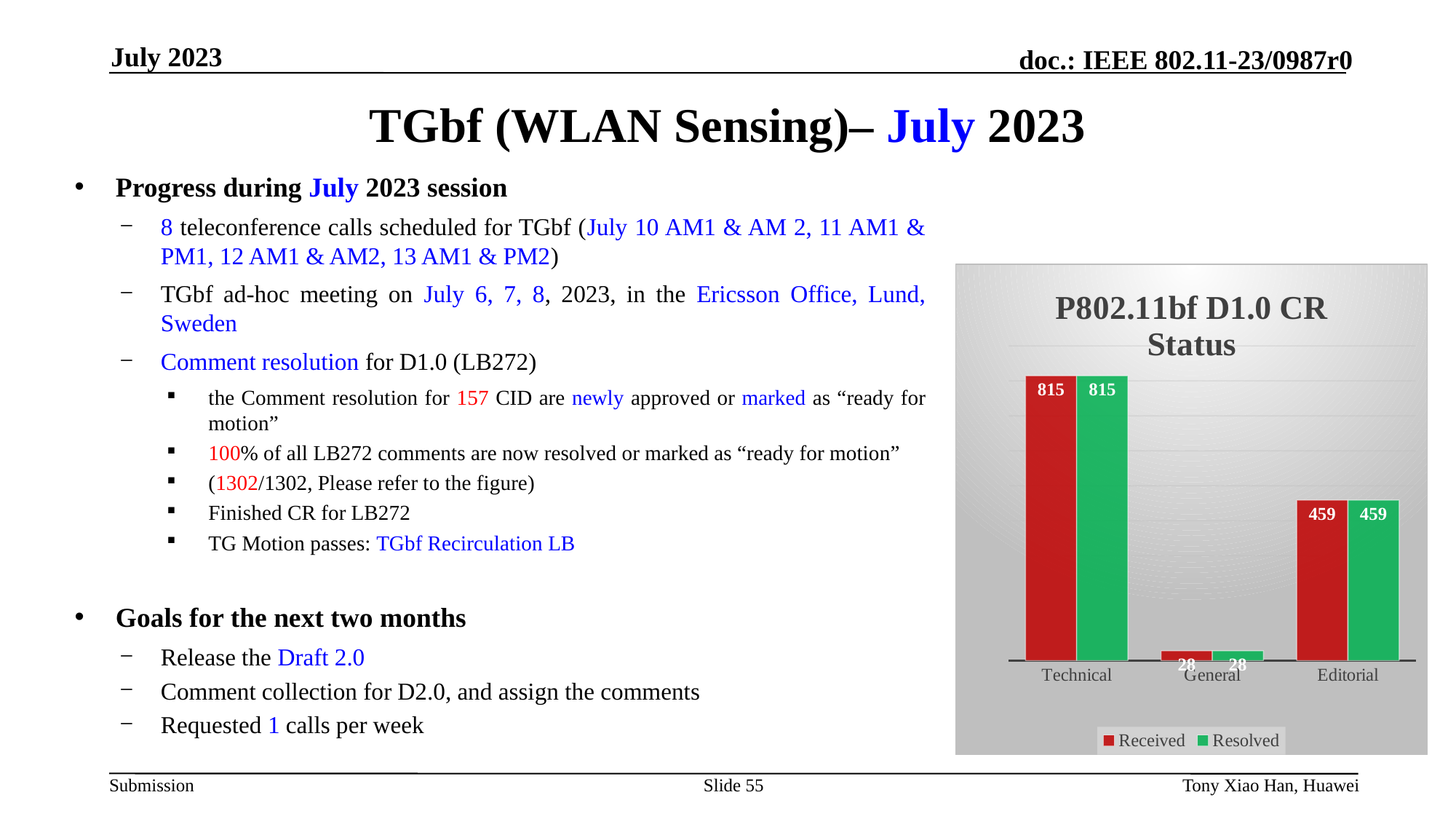
What is the difference between the Received values for Technical and Editorial? 356 What is the Received value for Technical? 815 How many series does the legend list? 2 Which colour represents the Resolved series? green Which is larger, the Resolved value for Editorial or the Resolved value for General? Editorial What is the Resolved value for Editorial? 459 What is the title of the chart? P802.11bf D1.0 CR Status What kind of chart is shown? bar chart What is the Received value for General? 28 How many categories are shown on the x axis? 3 Which category has the highest Received value? Technical Which category has the lowest Resolved value? General